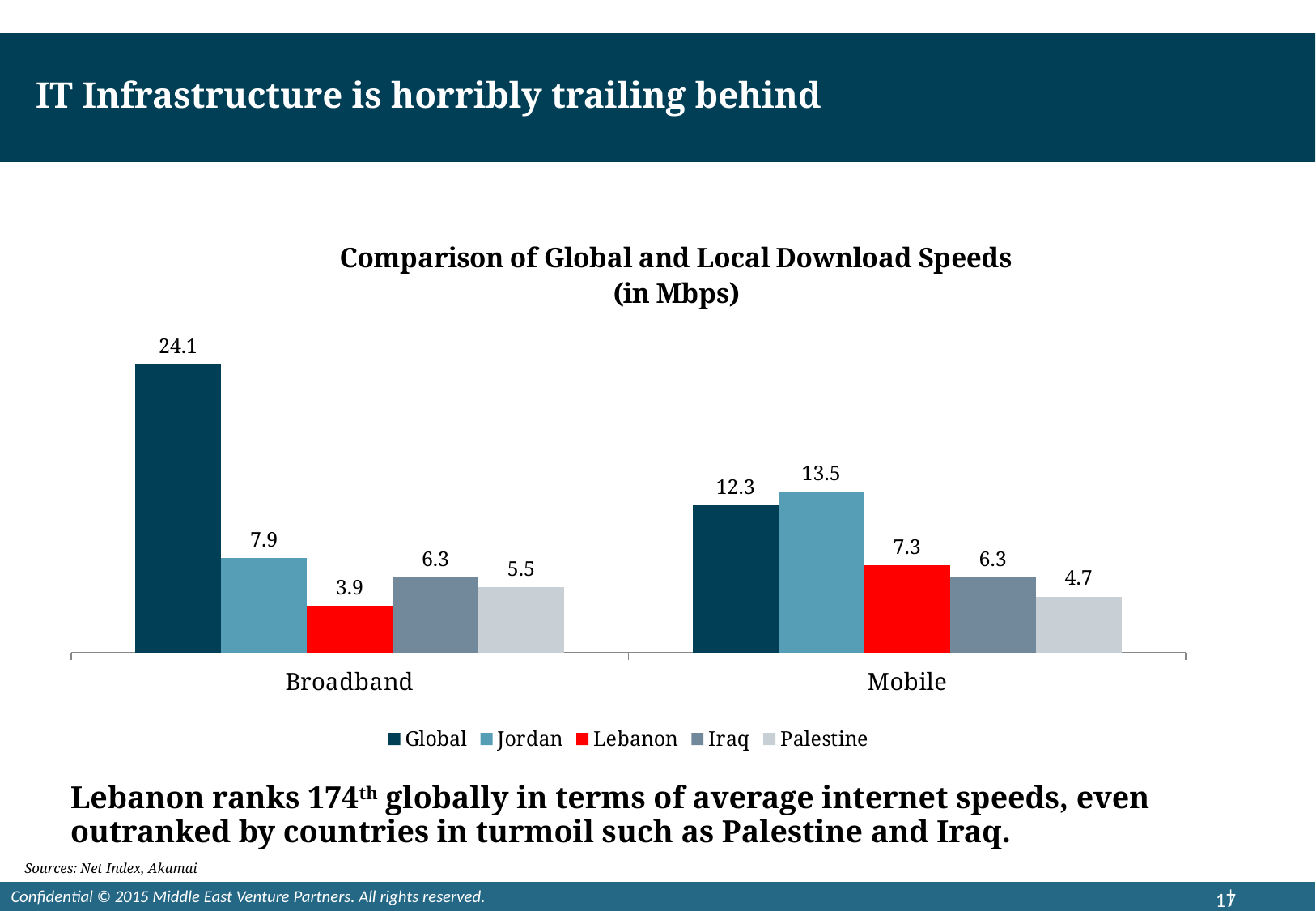
What is the difference between the Global and Lebanon Broadband download speeds? 20.2 Which is larger, Iraq's Broadband speed or Palestine's Broadband speed? Iraq's Broadband speed What kind of chart is shown on the slide? Bar chart Which series has the lowest Broadband download speed? Lebanon What is the title of the chart? Comparison of Global and Local Download Speeds (in Mbps) How many series does the legend list? 5 How many categories are shown on the x axis? 2 What is the difference between Jordan's Mobile and Broadband download speeds? 5.6 What is the Broadband download speed for Global? 24.1 Which series has the highest Mobile download speed? Jordan What is the Mobile download speed for Lebanon? 7.3 What is the Broadband download speed for Palestine? 5.5